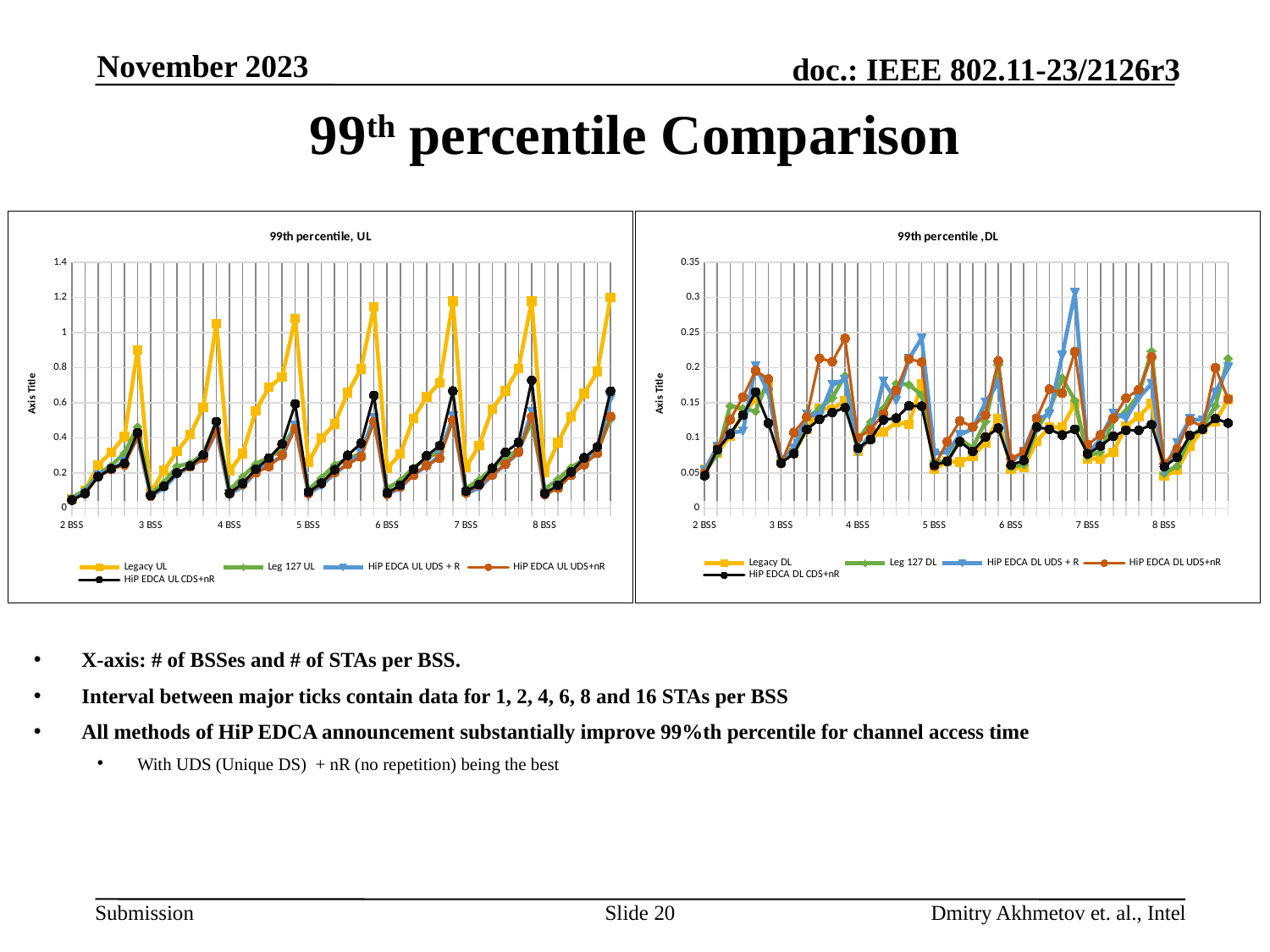
What kind of chart is the '99th percentile, UL' chart? line chart What kind of chart is the '99th percentile ,DL' chart? line chart In the '99th percentile ,DL' chart, is the highest value of the HiP EDCA DL UDS + R series greater or less than 0.25? greater How many series does the legend of the '99th percentile ,DL' chart list? 5 What is the maximum value shown on the y-axis of the '99th percentile ,DL' chart? 0.35 In the '99th percentile, UL' chart, which is larger at the 8 BSS peak: Legacy UL or HiP EDCA UL UDS+nR? Legacy UL In the '99th percentile, UL' chart, is the highest value of the HiP EDCA UL CDS+nR series greater or less than 1? less In the '99th percentile, UL' chart, is the highest value of the Legacy UL series greater or less than 1? greater In the '99th percentile, UL' chart, which series reaches the highest values? Legacy UL How many BSS categories are labelled on the x-axis of the '99th percentile, UL' chart? 7 What is the maximum value shown on the y-axis of the '99th percentile, UL' chart? 1.4 How many series does the legend of the '99th percentile, UL' chart list? 5